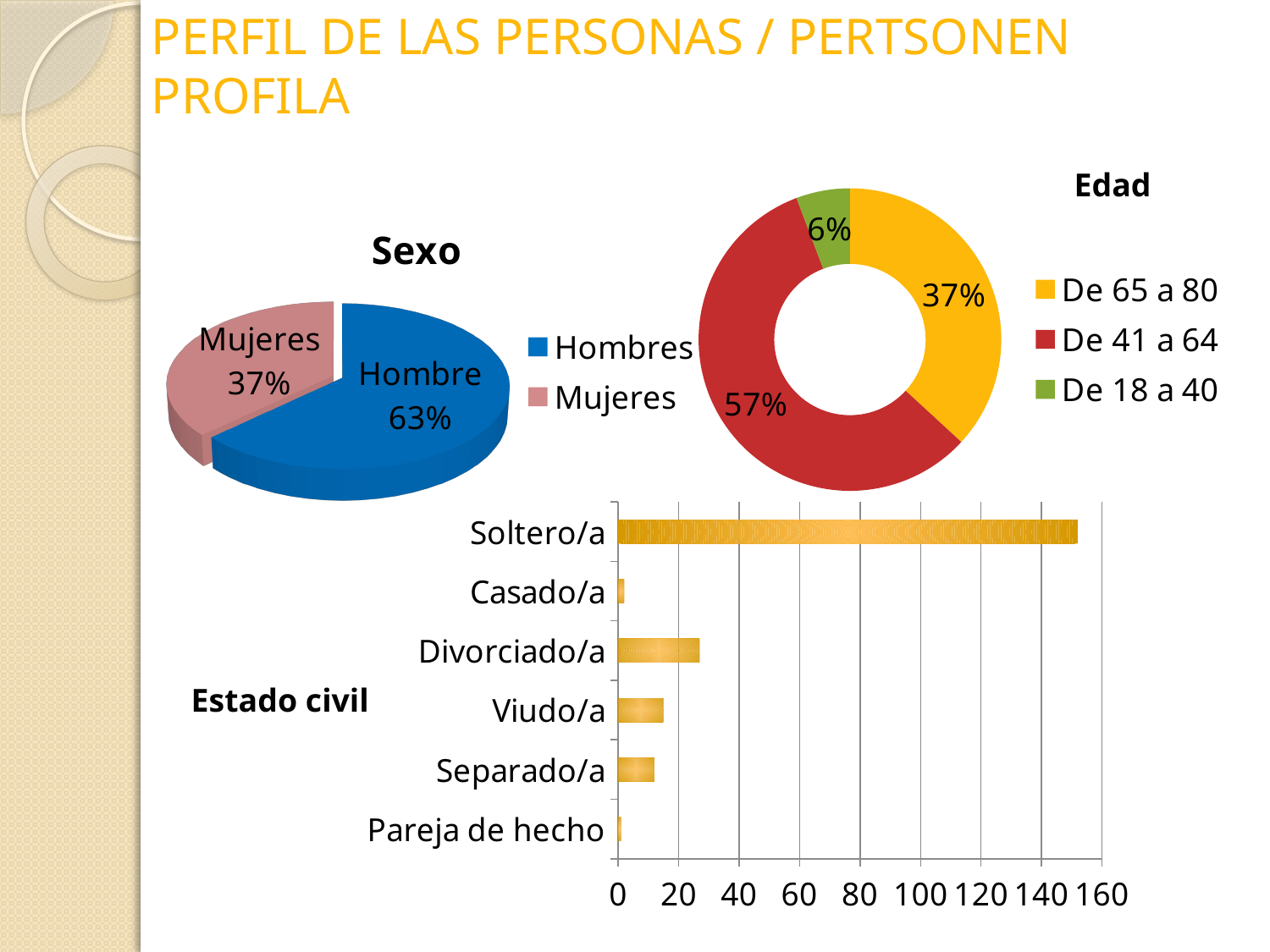
In the Estado civil chart, is the value for Soltero/a greater or less than 140? greater How many entries does the legend of the Edad chart list? 3 In the Sexo chart, what is the difference between the Hombres and Mujeres percentages? 26% What kind of chart is the Sexo chart? Pie chart In the Edad chart, what percentage is De 41 a 64? 57% In the Estado civil chart, which category has the highest value? Soltero/a In the Sexo chart, what percentage is Mujeres? 37% In the Edad chart, which age group has the smallest share? De 18 a 40 In the Estado civil chart, how many categories are shown? 6 In the Edad chart, what percentage is De 18 a 40? 6% In the Edad chart, which age group has the largest share? De 41 a 64 In the Sexo chart, what percentage is Hombres? 63%